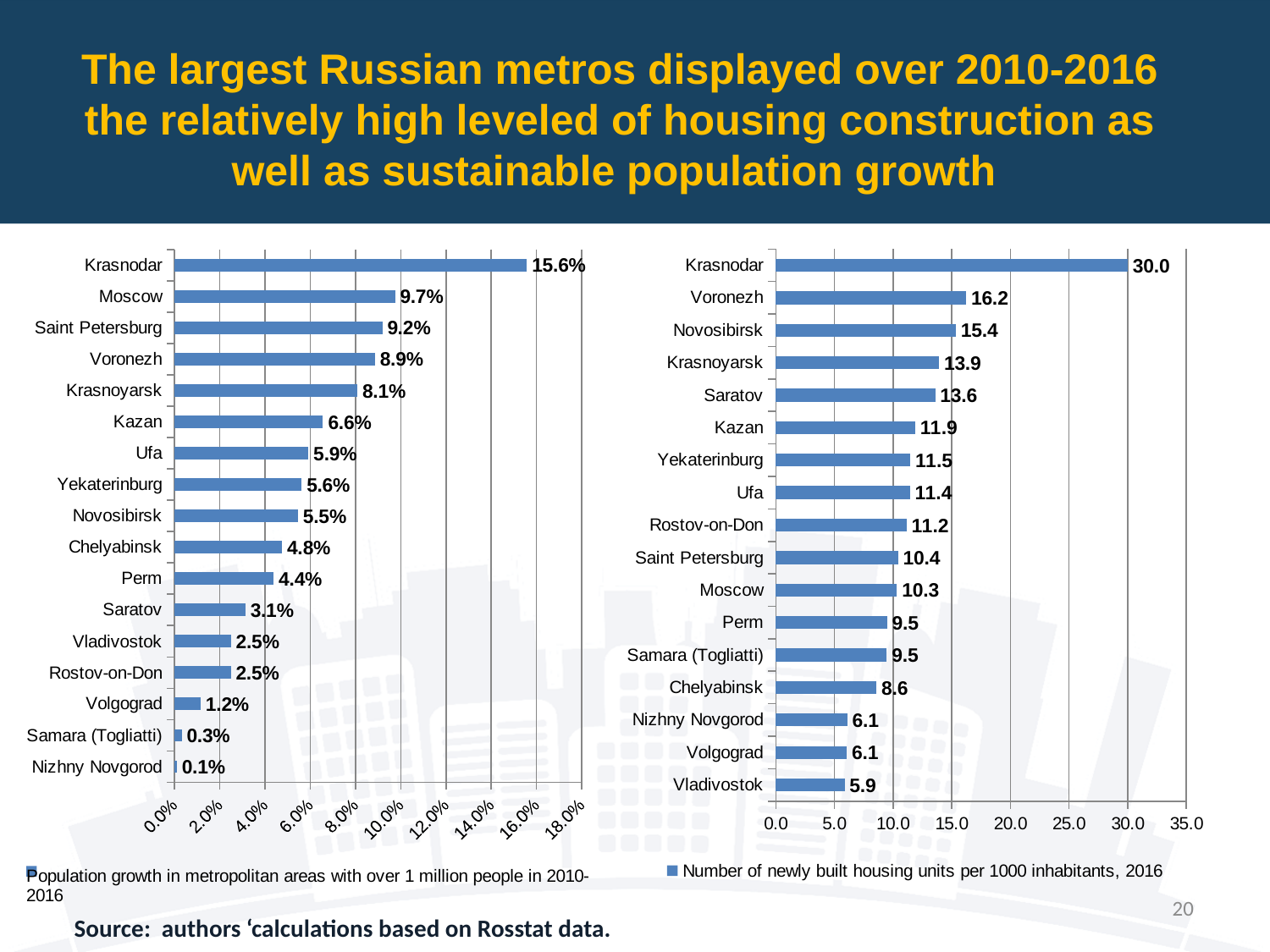
In the right chart (newly built housing units per 1000 inhabitants), what is the value for Chelyabinsk? 8.6 In the left chart (population growth), which is larger, Kazan or Saratov? Kazan In the left chart (population growth in metropolitan areas, 2010-2016), what is the value for Moscow? 9.7% How many metros are shown in the right chart (newly built housing units per 1000 inhabitants)? 17 In the left chart (population growth), what is the difference between Krasnodar and Moscow? 5.9% In the left chart (population growth), which metro has the highest value? Krasnodar What type of chart is the left chart (population growth)? Bar chart In the right chart (newly built housing units per 1000 inhabitants), which metro has the lowest value? Vladivostok In the right chart (newly built housing units per 1000 inhabitants), what is the difference between Krasnodar and Voronezh? 13.8 In the left chart (population growth), which metro has the lowest value? Nizhny Novgorod In the right chart (number of newly built housing units per 1000 inhabitants, 2016), what is the value for Voronezh? 16.2 In the right chart (newly built housing units per 1000 inhabitants), which is larger, Saint Petersburg or Novosibirsk? Novosibirsk